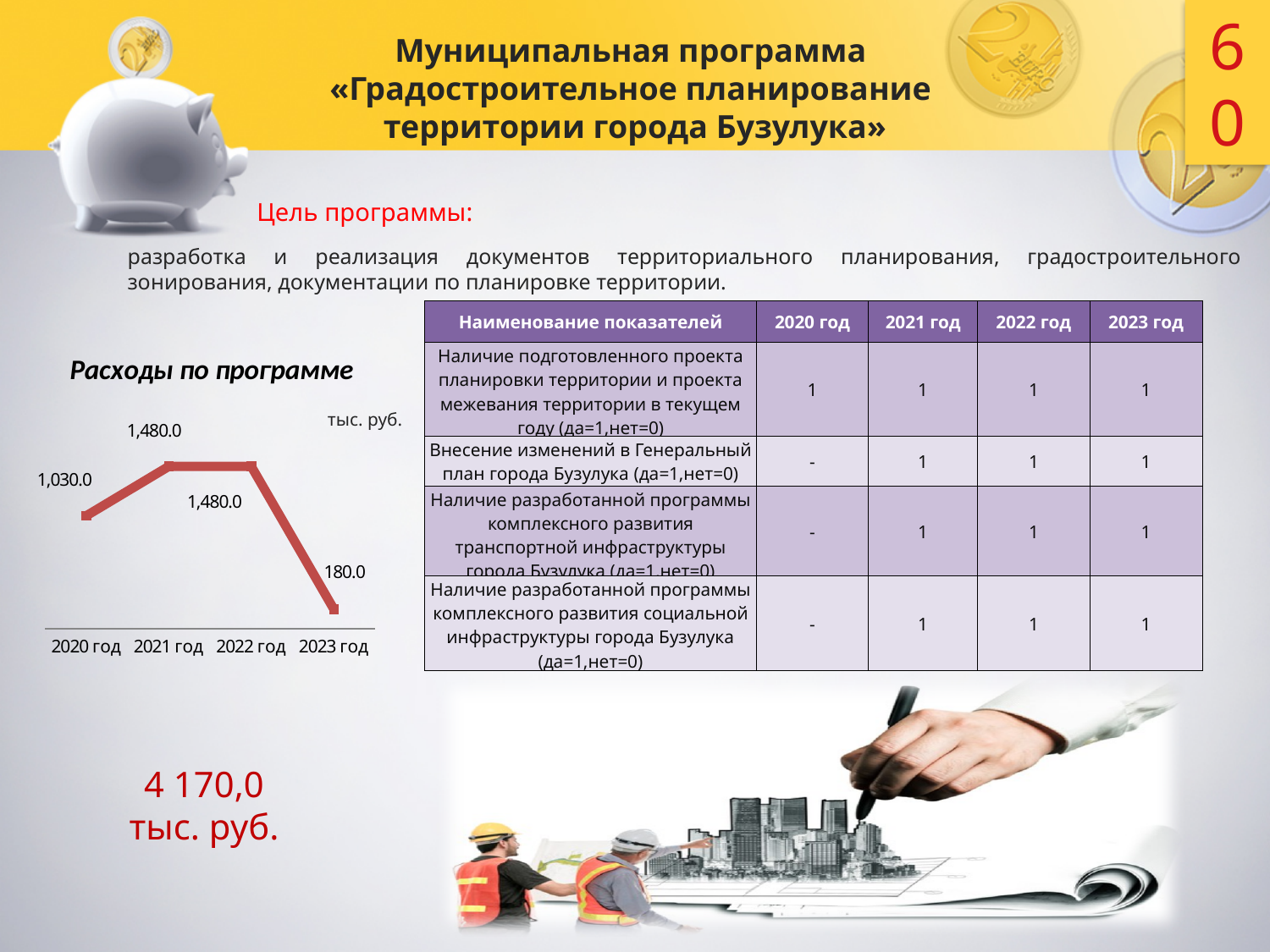
What type of chart is used to show 'Расходы по программе'? line chart What is the value for 2022 год in the 'Расходы по программе' chart? 1,480.0 In the 'Расходы по программе' chart, how does the value change from 2022 год to 2023 год? falls Which year has the lowest value in the 'Расходы по программе' chart? 2023 год What is the value for 2020 год in the 'Расходы по программе' chart? 1,030.0 What is the value for 2023 год in the 'Расходы по программе' chart? 180.0 What is the difference between the values for 2021 год and 2020 год in the 'Расходы по программе' chart? 450.0 What is the value for 2021 год in the 'Расходы по программе' chart? 1,480.0 Which is larger in the 'Расходы по программе' chart: the value for 2020 год or the value for 2023 год? 2020 год What is the difference between the values for 2022 год and 2023 год in the 'Расходы по программе' chart? 1,300.0 How many years are plotted in the 'Расходы по программе' chart? 4 What unit is indicated for the values in the 'Расходы по программе' chart? тыс. руб.